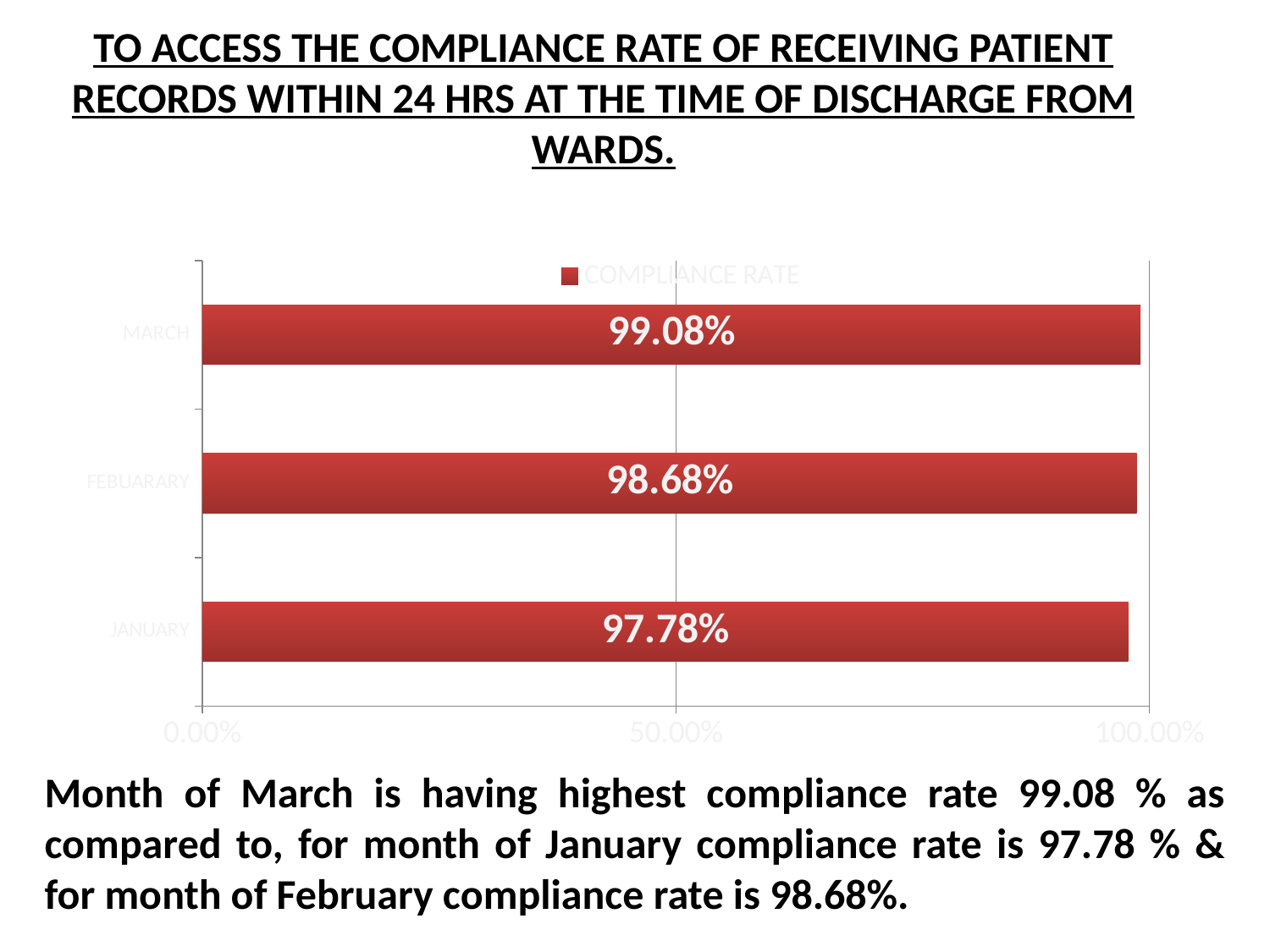
How many months are shown in the chart? 3 Which month has the lowest compliance rate? January Which month has the highest compliance rate? March What is the difference between the compliance rates for March and February? 0.40% What kind of chart is shown on the slide? Bar chart Is the compliance rate for January greater or less than 50.00%? greater What is the compliance rate for March? 99.08% Which has a higher compliance rate, February or January? February What series name does the chart legend show? COMPLIANCE RATE What is the difference between the compliance rates for March and January? 1.30% What is the compliance rate for January? 97.78% What is the compliance rate for February? 98.68%